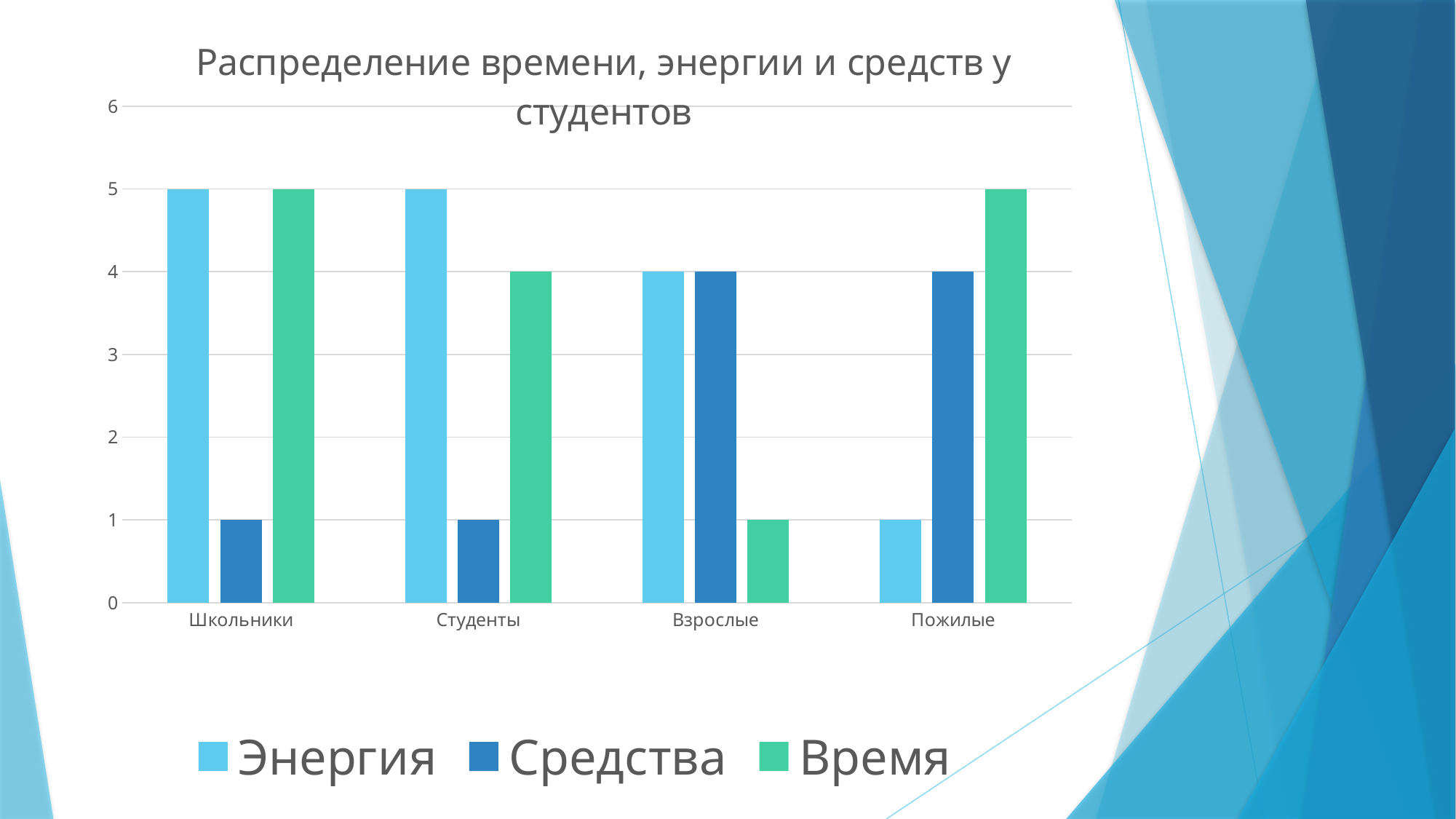
Which is larger for Студенты: Энергия or Средства? Энергия How many categories are shown on the x axis? 4 What is the title of the chart? Распределение времени, энергии и средств у студентов What type of chart is shown on the slide? Bar chart What is the difference between Время for Пожилые and Время for Взрослые? 4 Which category has the lowest value for Время? Взрослые What is the value of Средства for Взрослые? 4 Which category has the lowest value for Энергия? Пожилые What is the value of Энергия for Школьники? 5 How many series does the legend list? 3 Does the value of Энергия rise or fall from Школьники to Пожилые? Fall What is the value of Время for Студенты? 4